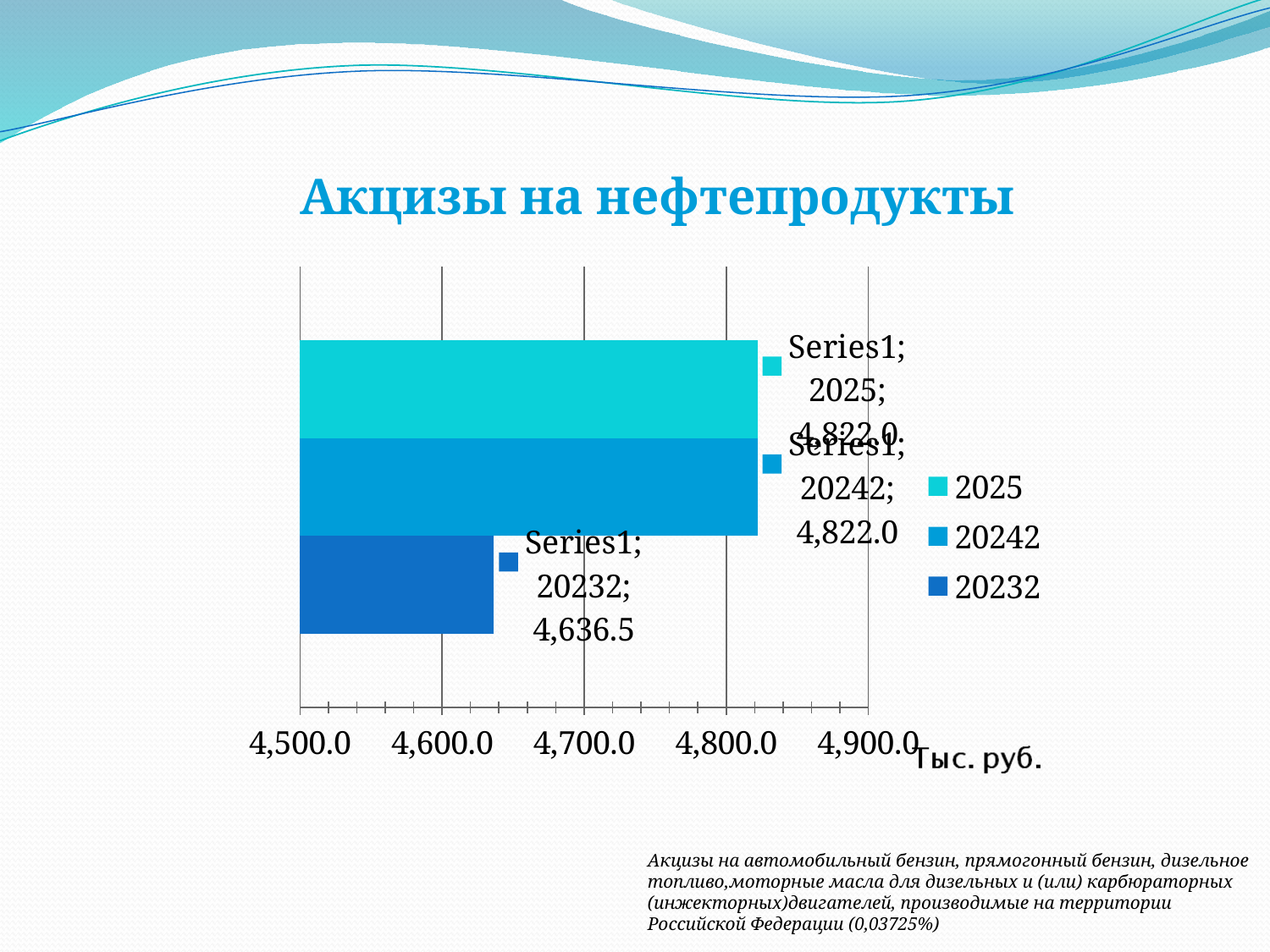
What is the difference between the values for 2025 and 20232? 185.5 What is the value for 2025 in the chart? 4,822.0 How many entries does the legend list? 3 What kind of chart is shown on the slide? bar chart What is the value for 20242 in the chart? 4,822.0 Is the value for 2025 greater or less than 4,800.0? greater Which is larger, the value for 20242 or the value for 20232? 20242 Is the value for 20232 greater or less than 4,700.0? less What is the value for 20232 in the chart? 4,636.5 How many bars are plotted in the chart? 3 What is the title of the chart? Акцизы на нефтепродукты Which category has the lowest value in the chart? 20232